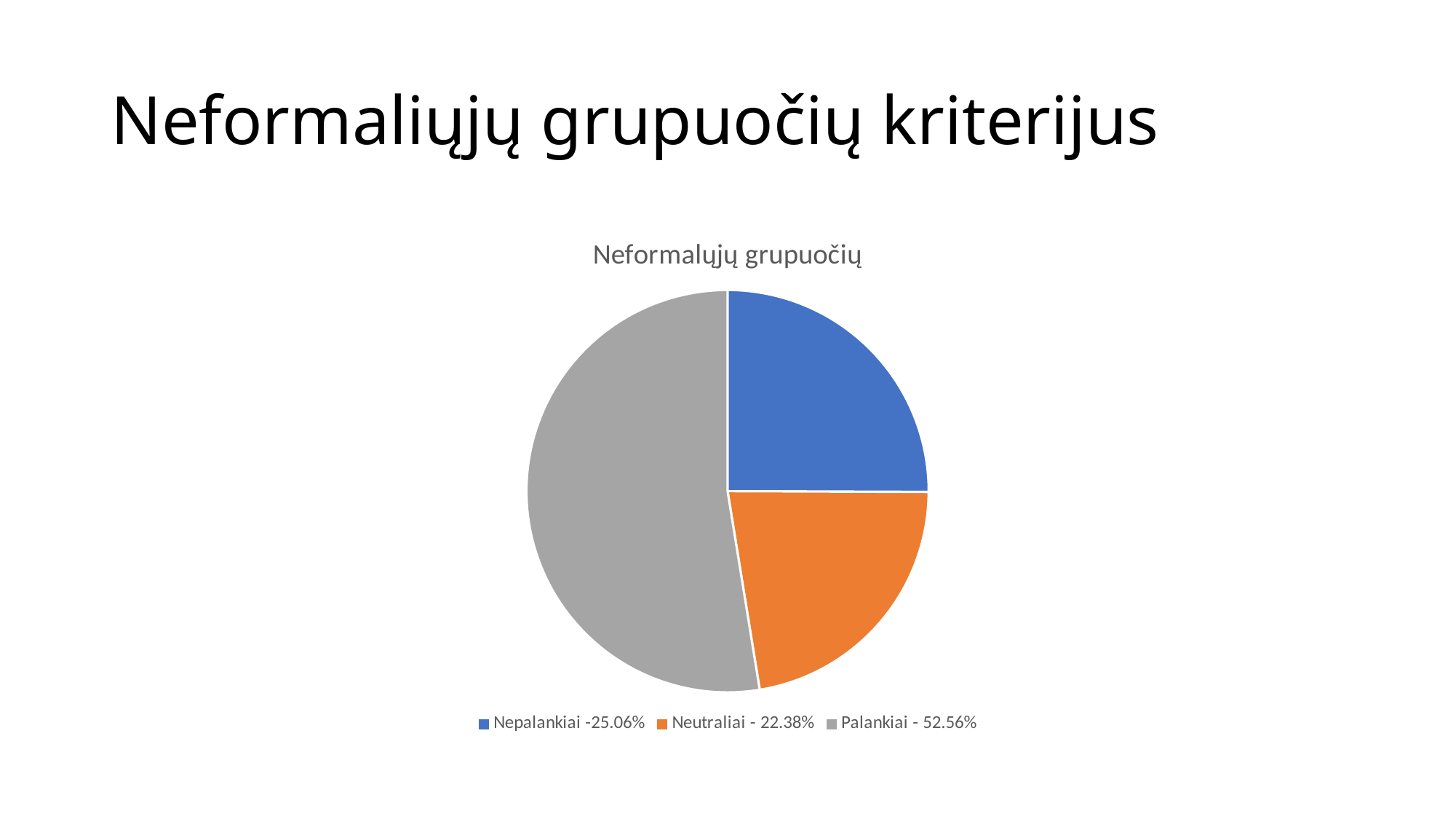
What percentage is shown for Neutraliai in the legend? 22.38% How many slices does the pie chart have? 3 What percentage is shown for Palankiai in the legend? 52.56% Which category has the smallest share of the pie? Neutraliai Which colour represents Neutraliai in the pie chart? orange Which is larger, the share for Nepalankiai or the share for Palankiai? Palankiai What is the difference between the Nepalankiai share and the Neutraliai share? 2.68% What percentage is shown for Nepalankiai in the legend? 25.06% What is the difference between the Palankiai share and the Nepalankiai share? 27.5% What kind of chart is shown on the slide? pie chart What is the title of the chart? Neformalųjų grupuočių Which category has the largest share of the pie? Palankiai